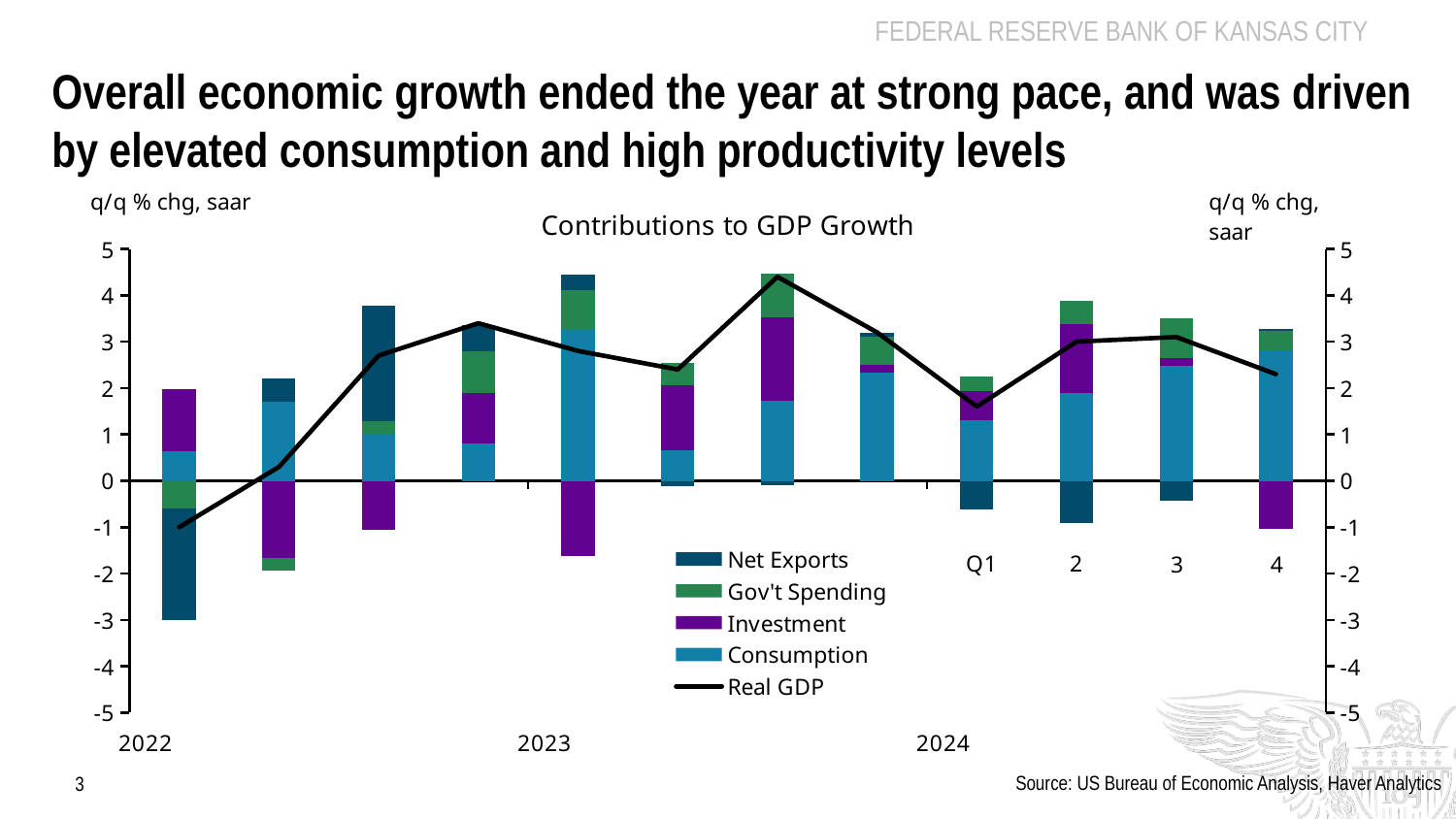
Does the Real GDP line rise or fall from the first quarter of 2022 to the first quarter of 2023? rise What kind of chart is shown on the slide? Stacked bar chart with a line How many quarterly bars are plotted in the chart? 12 What is the title of the chart? Contributions to GDP Growth Is the Real GDP value for 2024 Q1 greater or less than 2? less Which series is drawn as a black line rather than bars? Real GDP In which year does the Real GDP line reach its highest point? 2023 Is the Consumption contribution for 2024 Q4 greater or less than 2? greater How many series does the legend list? 5 In which year does the Real GDP line reach its lowest point? 2022 Is the Real GDP value for the first quarter of 2022 greater or less than 0? less